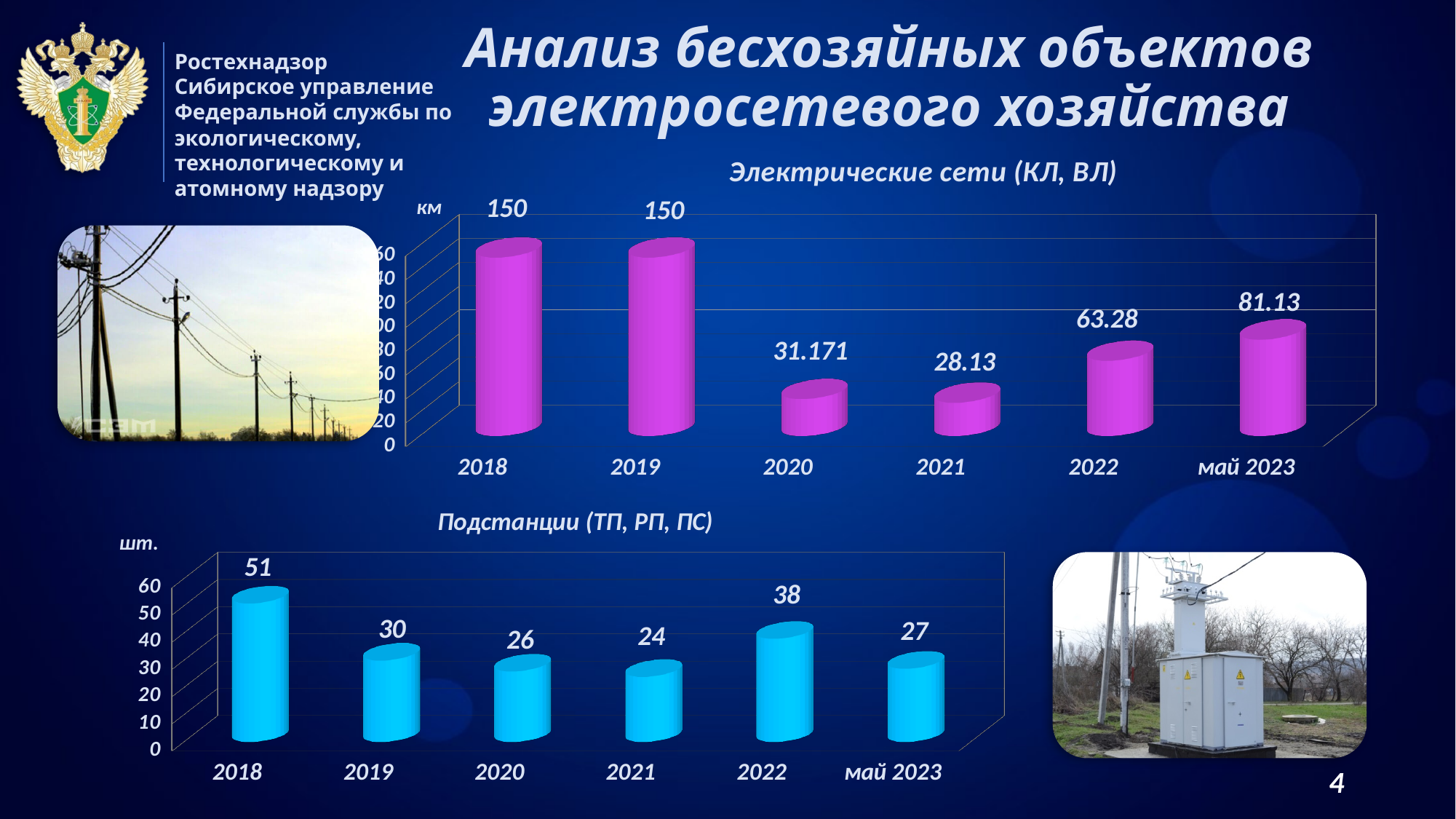
In the chart 'Электрические сети (КЛ, ВЛ)', what is the value for май 2023? 81.13 What type of chart is 'Подстанции (ТП, РП, ПС)'? Bar chart In the chart 'Подстанции (ТП, РП, ПС)', what is the value for 2022? 38 In the chart 'Подстанции (ТП, РП, ПС)', what is the difference between the values for 2018 and 2019? 21 In the chart 'Электрические сети (КЛ, ВЛ)', what is the value for 2020? 31.171 In the chart 'Электрические сети (КЛ, ВЛ)', what unit is shown on the vertical axis? км In the chart 'Электрические сети (КЛ, ВЛ)', which year has the lowest value? 2021 In the chart 'Подстанции (ТП, РП, ПС)', which is larger, the value for 2020 or the value for май 2023? май 2023 In the chart 'Подстанции (ТП, РП, ПС)', which year has the highest value? 2018 In the chart 'Электрические сети (КЛ, ВЛ)', what is the difference between the values for 2022 and 2021? 35.15 In the chart 'Подстанции (ТП, РП, ПС)', which year has the lowest value? 2021 In the chart 'Электрические сети (КЛ, ВЛ)', how many categories are shown on the x axis? 6